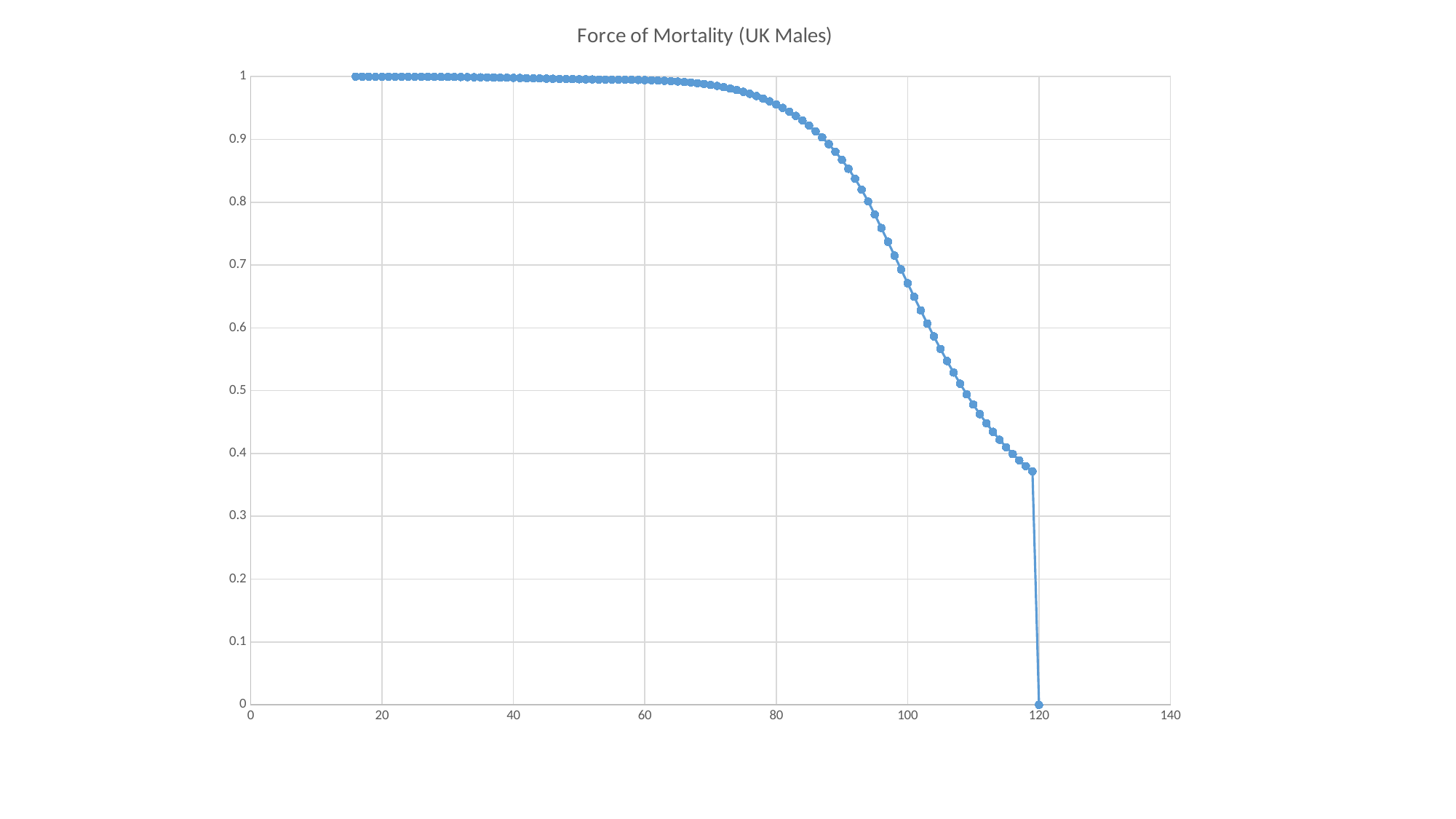
Around which x value does the plotted line drop to 0? 120 Is the value at x = 115 greater or less than 0.5? less Is the value at x = 100 greater or less than 0.5? greater What kind of chart is shown on the slide? line chart Is the value at x = 80 greater or less than 0.9? greater Do the plotted values rise or fall as the x axis increases? fall What is the highest value shown on the y axis? 1 What is the title of the chart? Force of Mortality (UK Males) Which is larger, the value at x = 40 or the value at x = 100? x = 40